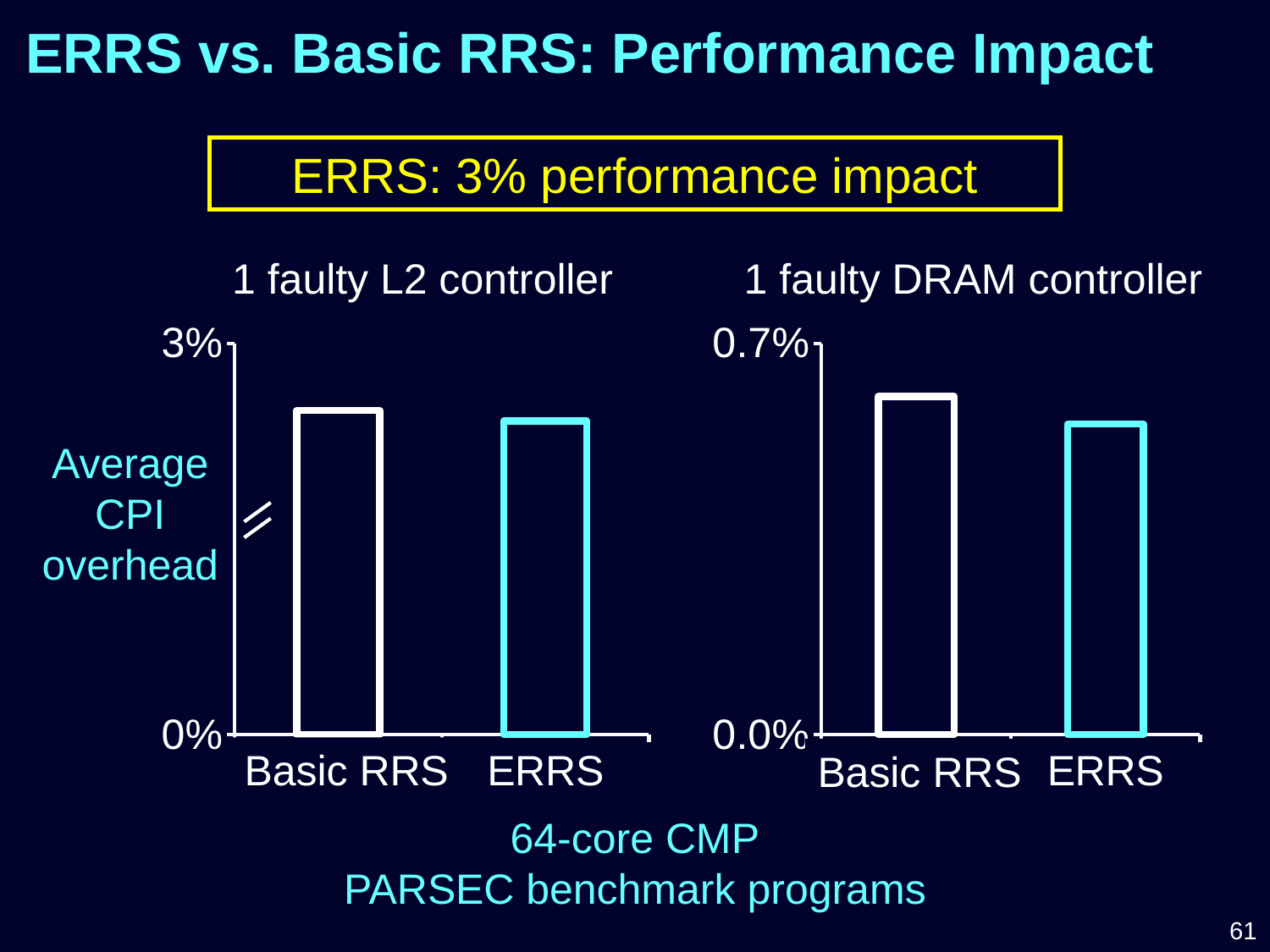
What are the two category labels on the x axis of the '1 faulty L2 controller' chart? Basic RRS and ERRS What is the top tick label on the y axis of the '1 faulty L2 controller' chart? 3% What kind of chart is the '1 faulty L2 controller' chart? bar chart In the '1 faulty DRAM controller' chart, which is larger, Basic RRS or ERRS? Basic RRS In the '1 faulty DRAM controller' chart, is the value for Basic RRS greater or less than 0.7%? less In the '1 faulty DRAM controller' chart, which category has the lowest value? ERRS In the '1 faulty DRAM controller' chart, is the value for ERRS greater or less than 0.7%? less How many bars are in the '1 faulty DRAM controller' chart? 2 What is the top tick label on the y axis of the '1 faulty DRAM controller' chart? 0.7% In the '1 faulty L2 controller' chart, is the value for ERRS greater or less than 3%? less